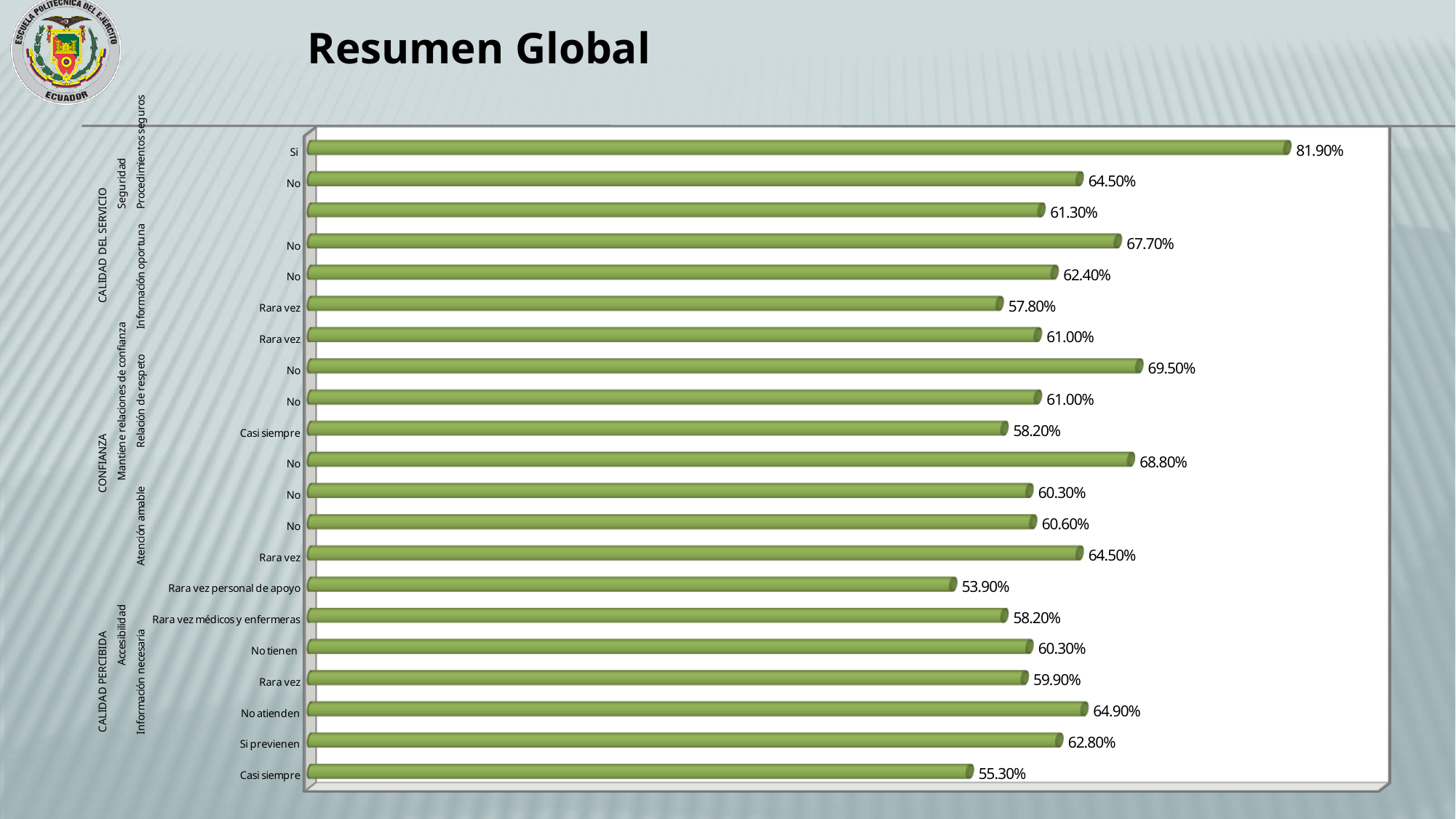
What is the value for "No atienden"? 64.90% What is the title of the slide containing the chart? Resumen Global What type of chart is shown on the slide? bar chart Which bar has the lowest value in the chart? Rara vez personal de apoyo What is the value for "Rara vez médicos y enfermeras"? 58.20% What is the value of the bar labelled "Si" at the top of the chart? 81.90% Which bar has the highest value in the chart? Si What is the value for "Si previenen"? 62.80% How many bars are plotted in the chart? 21 What is the difference between the value for "Si" (top bar) and the value for "No atienden"? 17.00% What is the value for "Rara vez personal de apoyo"? 53.90% Which is larger, the value for "No atienden" or the value for "Si previenen"? No atienden